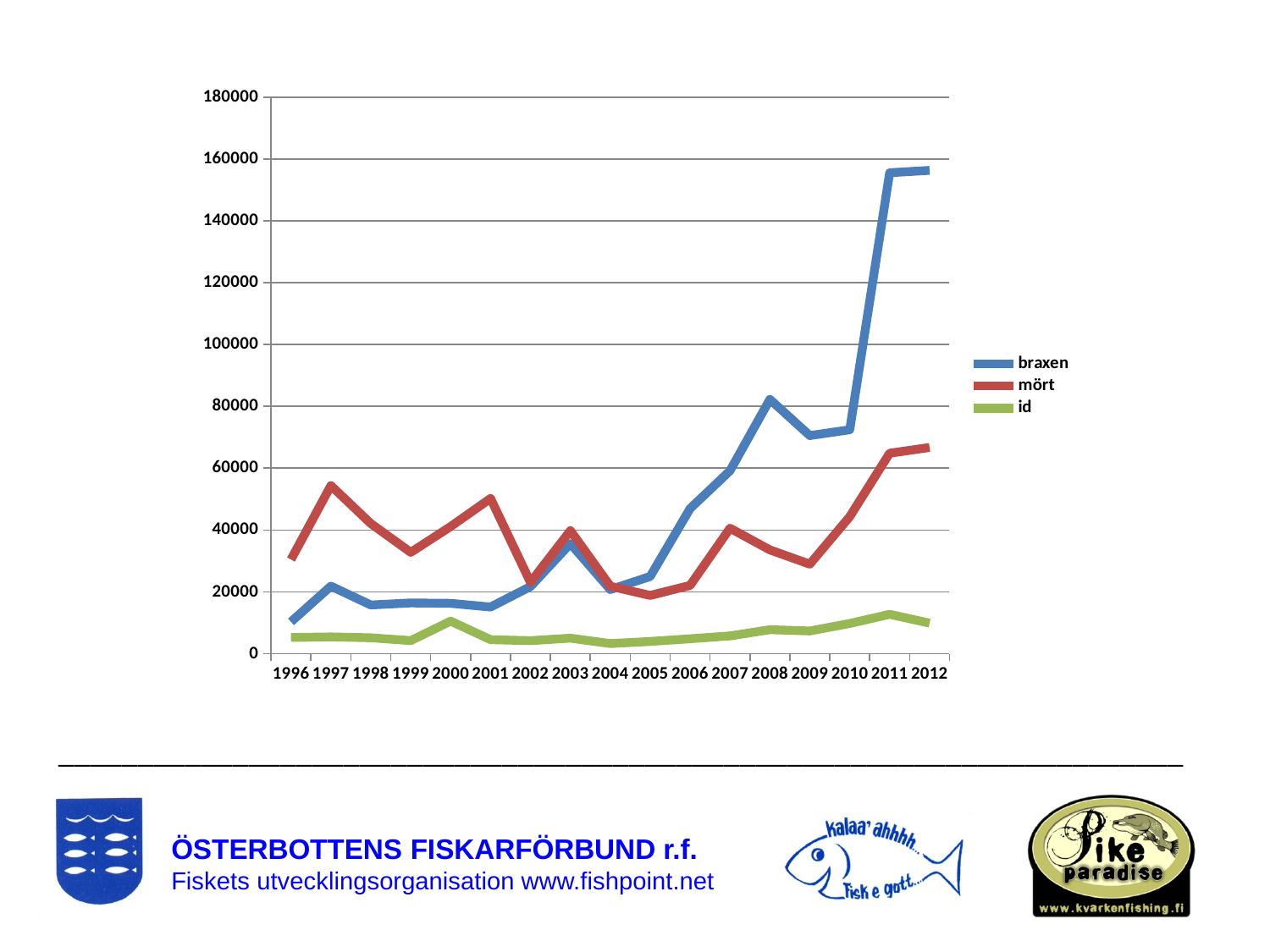
In 1997, which is larger, the value for braxen or the value for mört? mört Does the braxen series overall rise or fall from 1996 to 2012? rise What colour is the line for braxen? blue Is the value for mört in 1997 greater or less than 40000? greater How many years are shown on the x axis? 17 Is the value for mört in 2012 greater or less than 60000? greater Which series has the highest value in 2012? braxen How many series does the legend list? 3 Is the value for id in 2011 greater or less than 20000? less Which series has the lowest value in 2012? id What kind of chart is shown on the slide? line chart